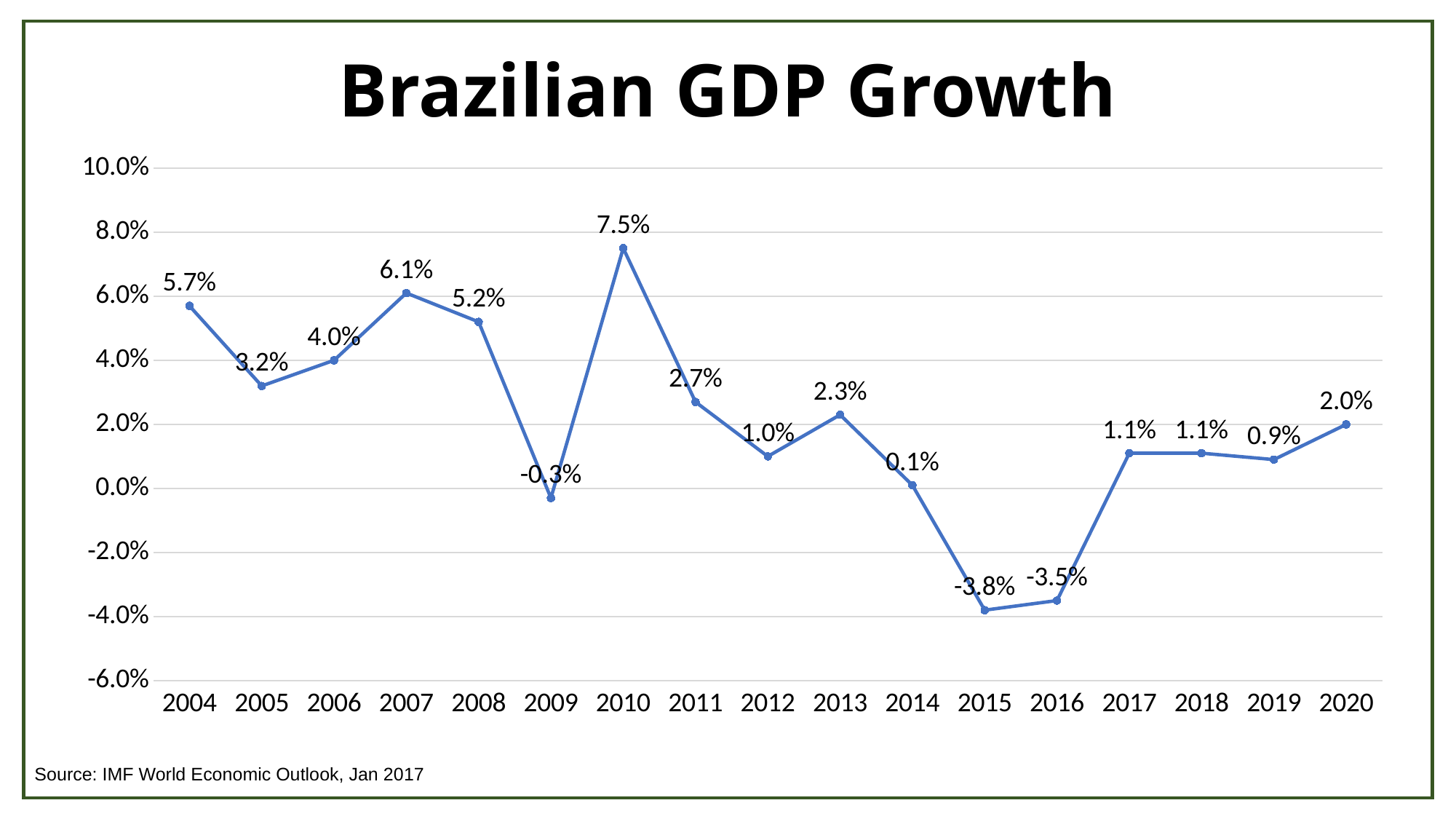
What is the title of the chart? Brazilian GDP Growth What is the GDP growth value shown for 2015? -3.8% What kind of chart is shown on the slide? Line chart What is the difference between the GDP growth values for 2010 and 2011? 4.8% Do the GDP growth values rise or fall from 2016 to 2017? Rise Which year has the larger GDP growth value, 2004 or 2006? 2004 Which year has the lowest GDP growth value? 2015 What is the GDP growth value shown for 2009? -0.3% Which year has the highest GDP growth value? 2010 What is the difference between the GDP growth values for 2007 and 2008? 0.9% What is the Brazilian GDP growth value for 2010? 7.5% How many years are plotted on the chart? 17